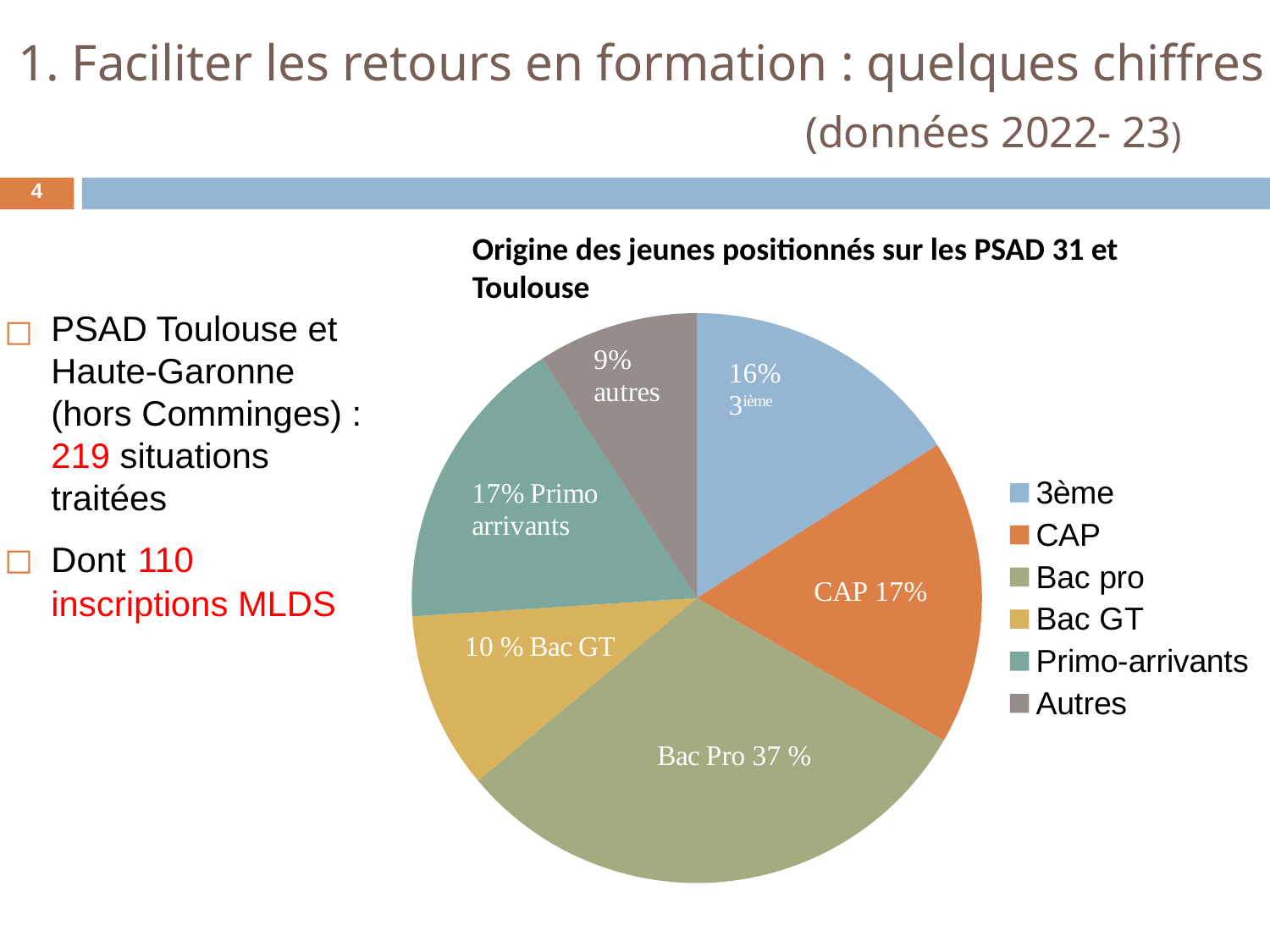
What percentage is shown for Primo-arrivants? 17% What is the difference in percentage points between Bac pro and Bac GT? 27 What type of chart is shown on the slide? Pie chart How many categories does the pie chart show? 6 What percentage is shown for Autres? 9% What percentage is shown for CAP? 17% What share of the pie does Bac pro represent? 37 % Which category has the largest slice of the pie? Bac pro Which category has the smallest slice of the pie? Autres What percentage is shown for Bac GT? 10 % What percentage is shown for 3ème? 16% Which is larger, the share for 3ème or the share for Bac GT? 3ème